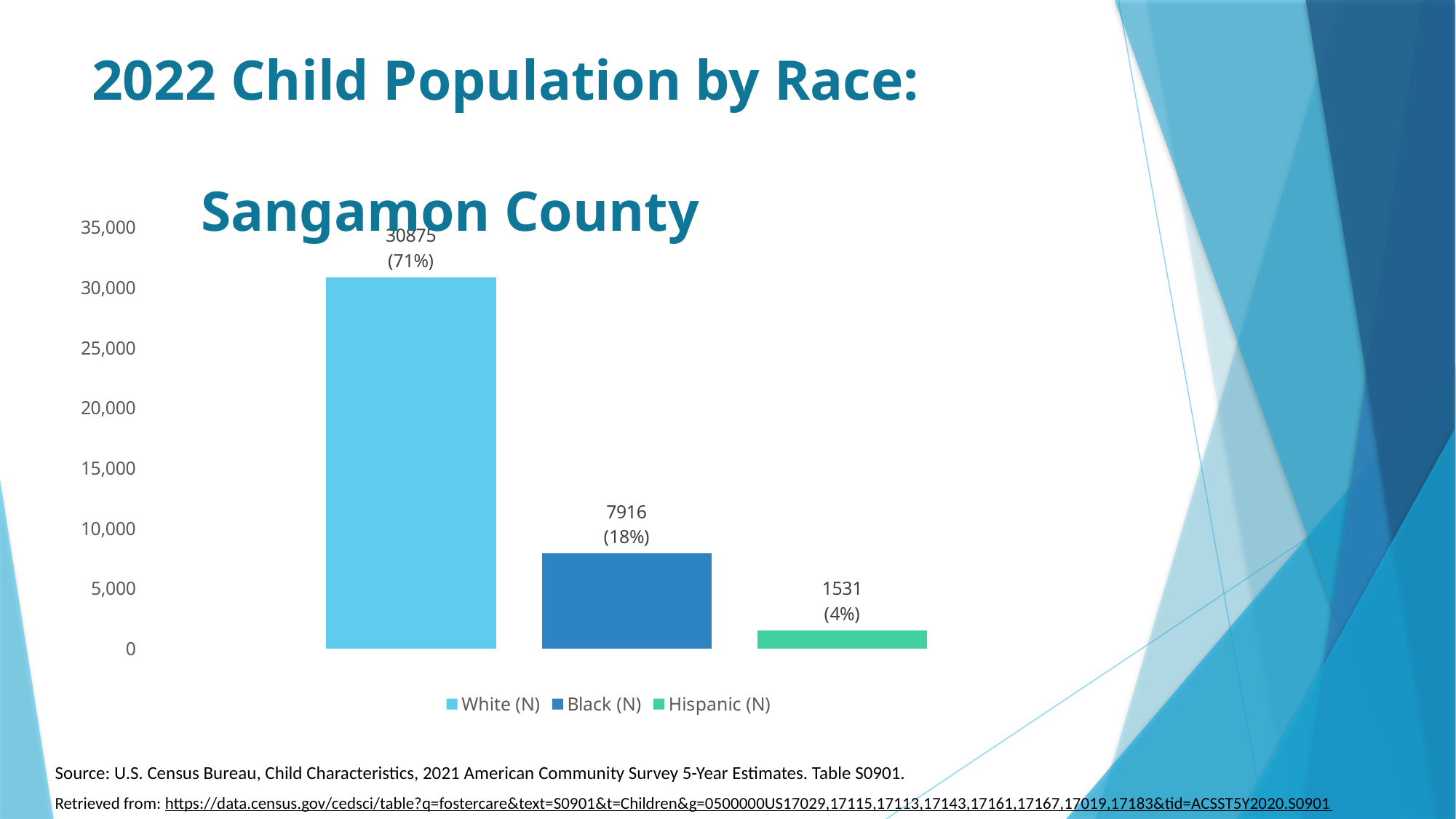
How many groups are plotted in the chart? 3 What percentage is shown for Black (N)? 18% How many entries does the legend list? 3 What kind of chart is shown on the slide? bar chart What is the value for White (N)? 30875 What is the value for Hispanic (N)? 1531 Which is larger, the value for Black (N) or Hispanic (N)? Black (N) What is the value for Black (N)? 7916 Which group has the highest child population? White (N) Is the value for Black (N) greater or less than 10,000? less What is the difference between the White (N) and Black (N) values? 22959 Which group has the lowest child population? Hispanic (N)